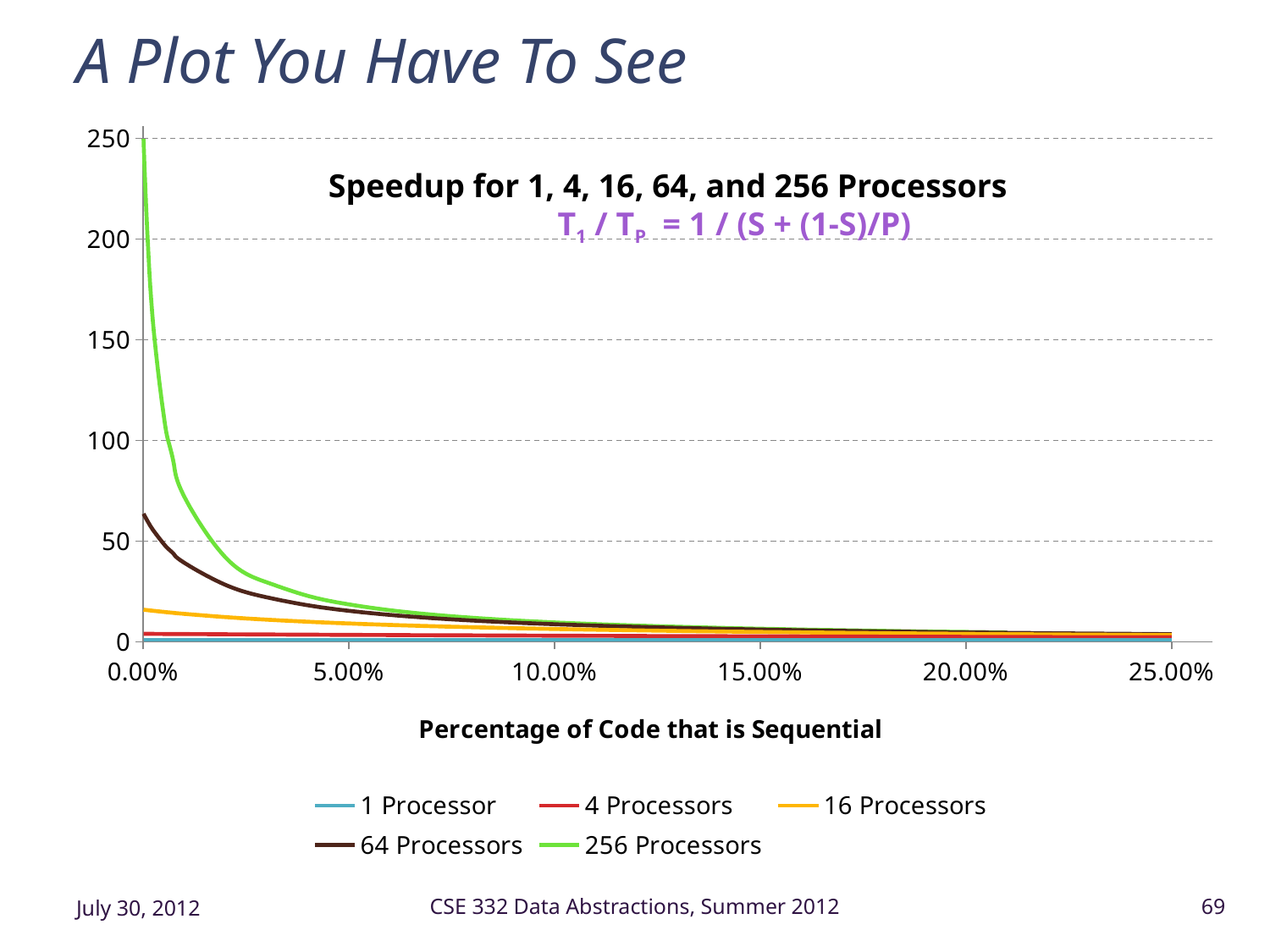
Is the value for 64 Processors at 0.00% sequential code greater or less than 50? greater At 0.00% sequential code, which is larger: the value for 64 Processors or the value for 256 Processors? 256 Processors Is the value for 256 Processors at 5.00% sequential code greater or less than 50? less Which series has the highest value at 0.00% sequential code? 256 Processors What is the title of the chart? Speedup for 1, 4, 16, 64, and 256 Processors What is the label of the x axis? Percentage of Code that is Sequential Do the values for the 256 Processors series rise or fall as the percentage of sequential code increases? fall Which series has the lowest values across the chart? 1 Processor At 2.00% sequential code, which is larger: the value for 16 Processors or the value for 64 Processors? 64 Processors What kind of chart is shown on the slide? line chart Is the value for 256 Processors at 0.00% sequential code greater or less than 200? greater How many series does the legend list? 5